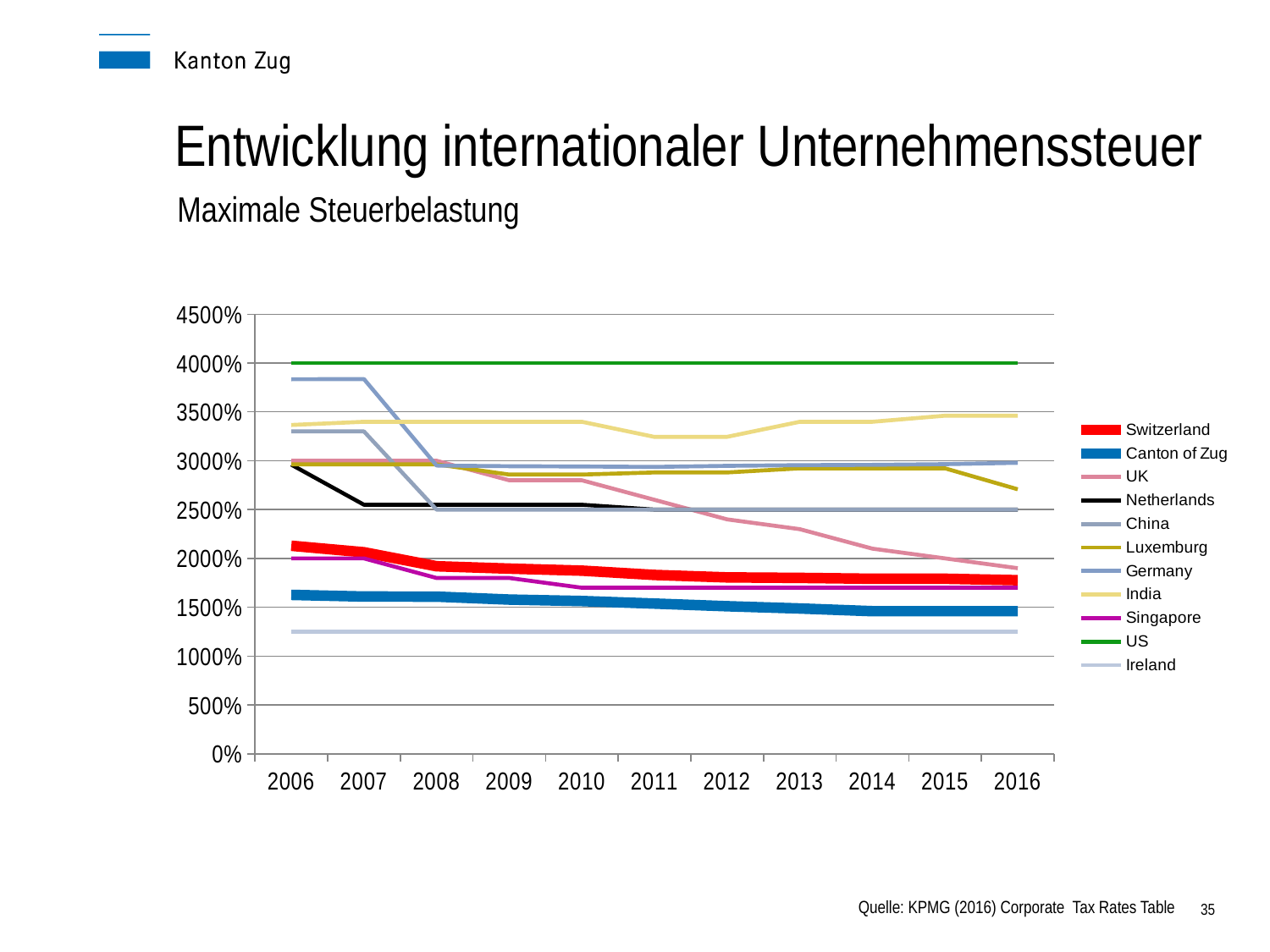
Does the US line rise, fall or stay flat from 2006 to 2016? stay flat Is the value for India in 2016 greater or less than 3000%? greater How many years are shown along the x axis? 11 Which series has the lowest value in 2016? Ireland In 2016, which is larger: Switzerland or Canton of Zug? Switzerland Is the value for Luxemburg in 2016 greater or less than 2500%? greater What is the title of the slide containing the chart? Entwicklung internationaler Unternehmenssteuer Which series has the highest value in 2016? US Is the value for Canton of Zug in 2006 greater or less than 2000%? less Does the UK line rise or fall from 2006 to 2016? fall How many series does the legend list? 11 What kind of chart is shown on the slide? line chart